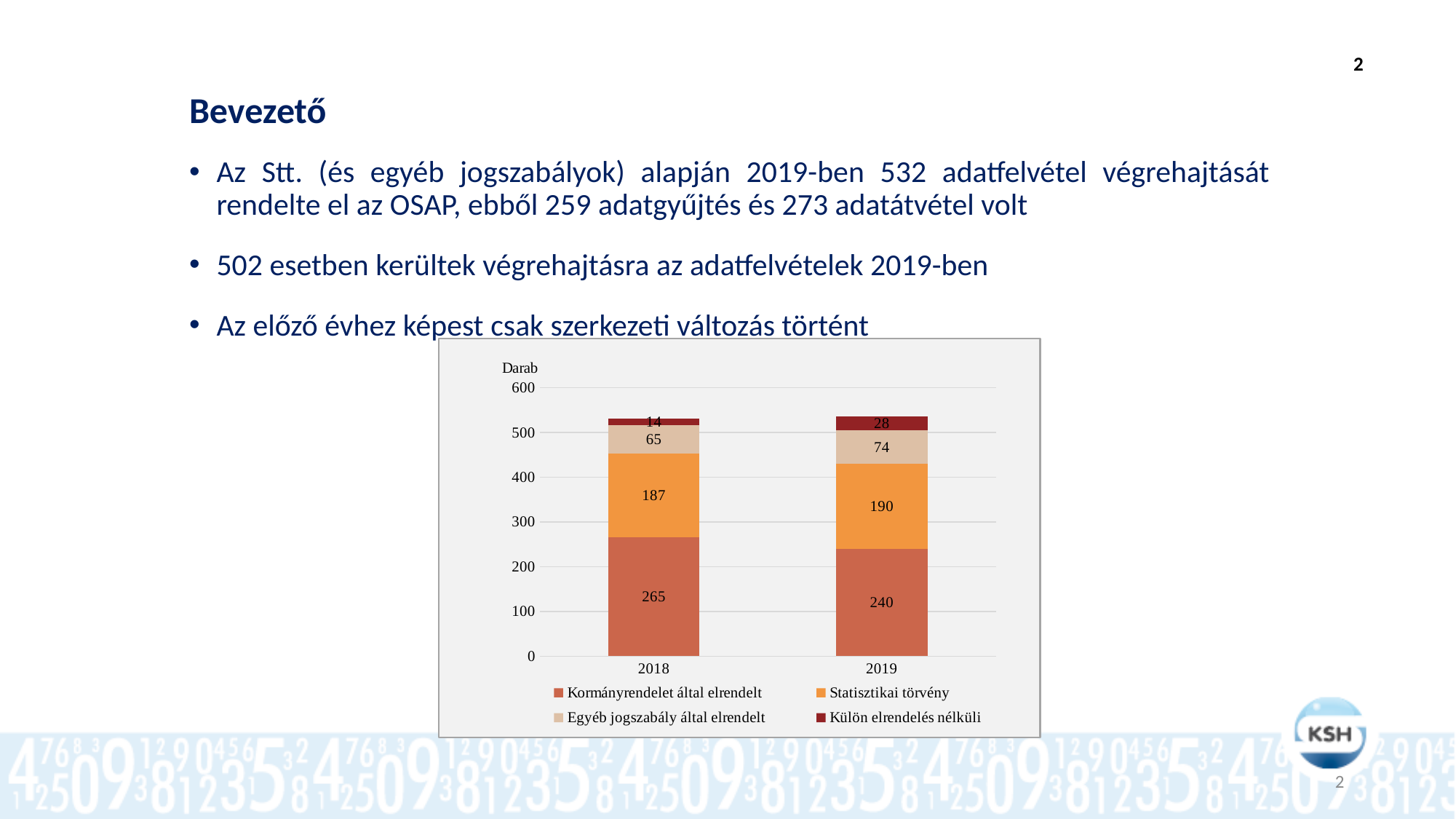
What is the total of the stacked bar for 2018? 531 Which series has the lowest value in 2018? Külön elrendelés nélküli How many series does the legend list? 4 Which series has the highest value in 2019? Kormányrendelet által elrendelt What is the value for Külön elrendelés nélküli in 2019? 28 What is the value for Egyéb jogszabály által elrendelt in 2018? 65 What is the total of the stacked bar for 2019? 532 What kind of chart is shown on the slide? Stacked bar chart What is the value for Kormányrendelet által elrendelt in 2018? 265 Which is larger, the Külön elrendelés nélküli value in 2018 or in 2019? 2019 What is the value for Statisztikai törvény in 2019? 190 What is the difference between the Kormányrendelet által elrendelt values for 2018 and 2019? 25